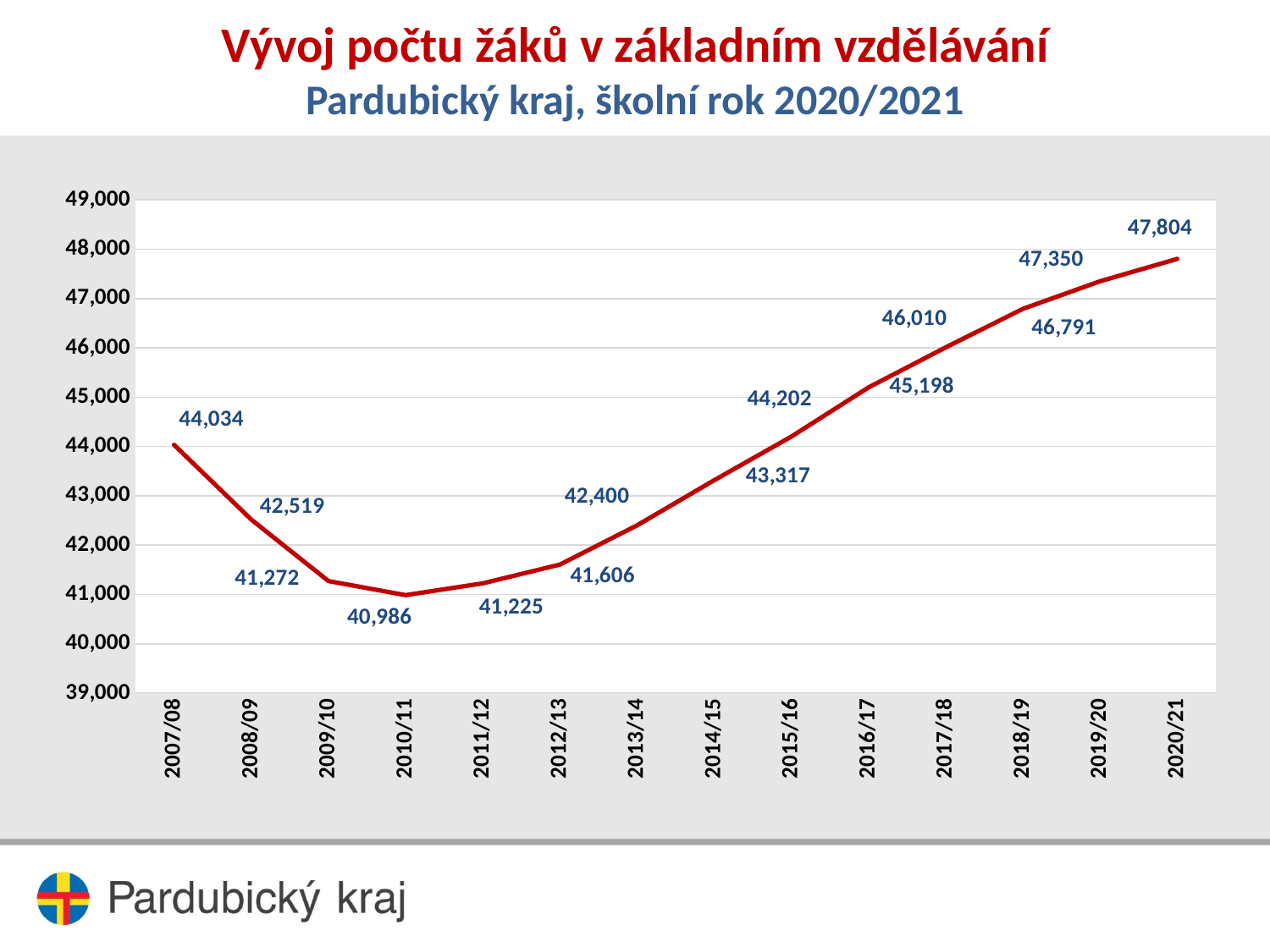
Which school year has the lowest number of pupils? 2010/11 What kind of chart is shown on the slide? line chart What is the difference between the values for 2007/08 and 2008/09? 1,515 What is the number of pupils for 2020/21? 47,804 Which is larger, the value for 2007/08 or the value for 2015/16? 2015/16 What is the number of pupils for 2007/08? 44,034 Is the value for 2017/18 greater or less than 46,000? greater What is the difference between the values for 2020/21 and 2010/11? 6,818 Which school year has the highest number of pupils? 2020/21 How many school years are plotted on the chart? 14 Do the values rise or fall from 2010/11 to 2020/21? rise What is the value plotted for 2014/15? 43,317